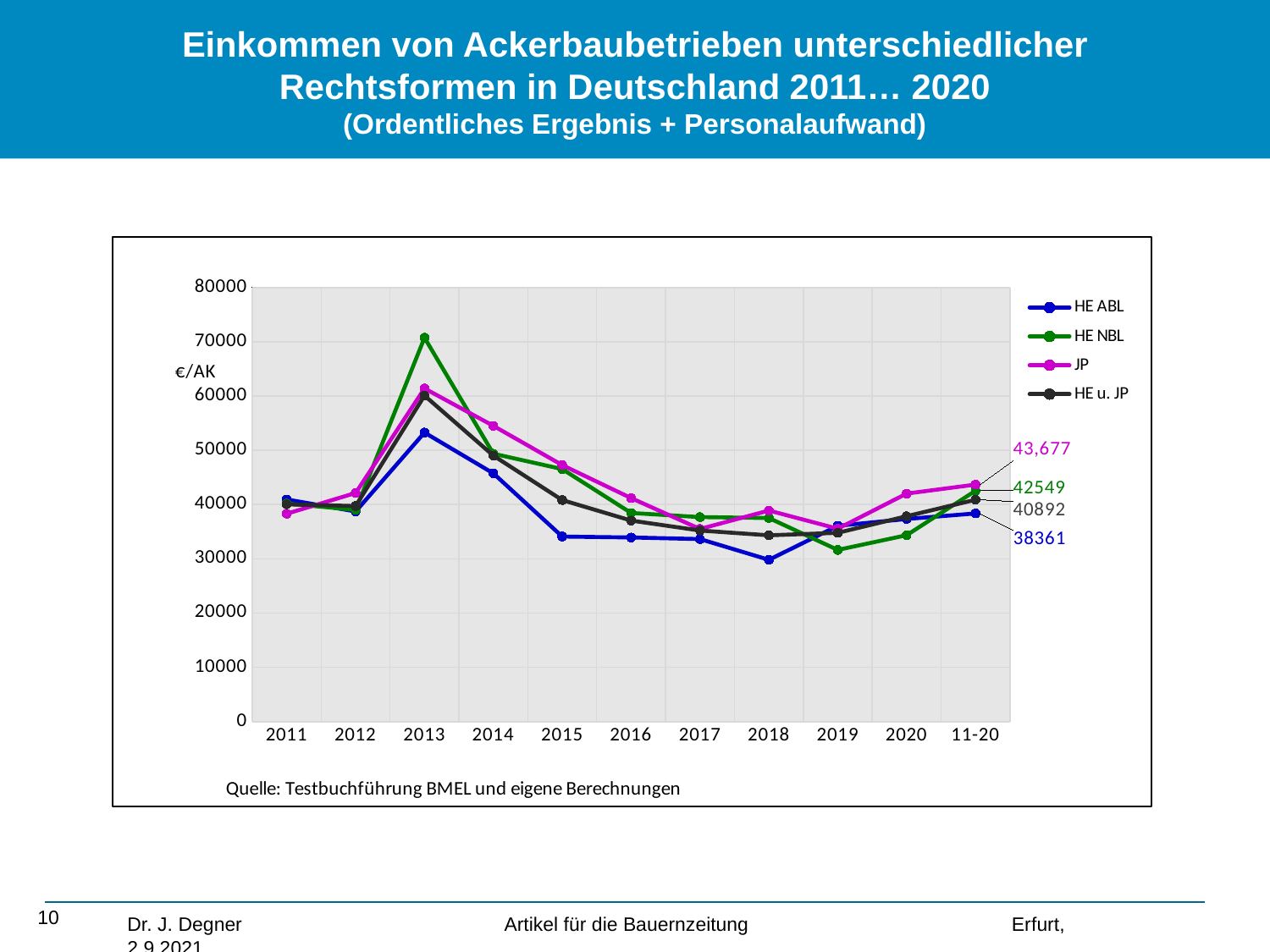
How many categories are shown on the x axis? 11 What is the value for HE NBL at 11-20? 42549 Which series has the highest value at 11-20? JP What type of chart is shown on the slide? line chart What is the value for HE ABL at 11-20? 38361 How many series does the legend list? 4 Which series has the lowest value at 11-20? HE ABL What is the difference between the JP and HE ABL values at 11-20? 5316 What is the value for JP at 11-20? 43,677 What unit is shown on the y axis? €/AK Is the value for HE NBL in 2013 greater or less than 60000? greater In which year does HE NBL reach its highest value? 2013